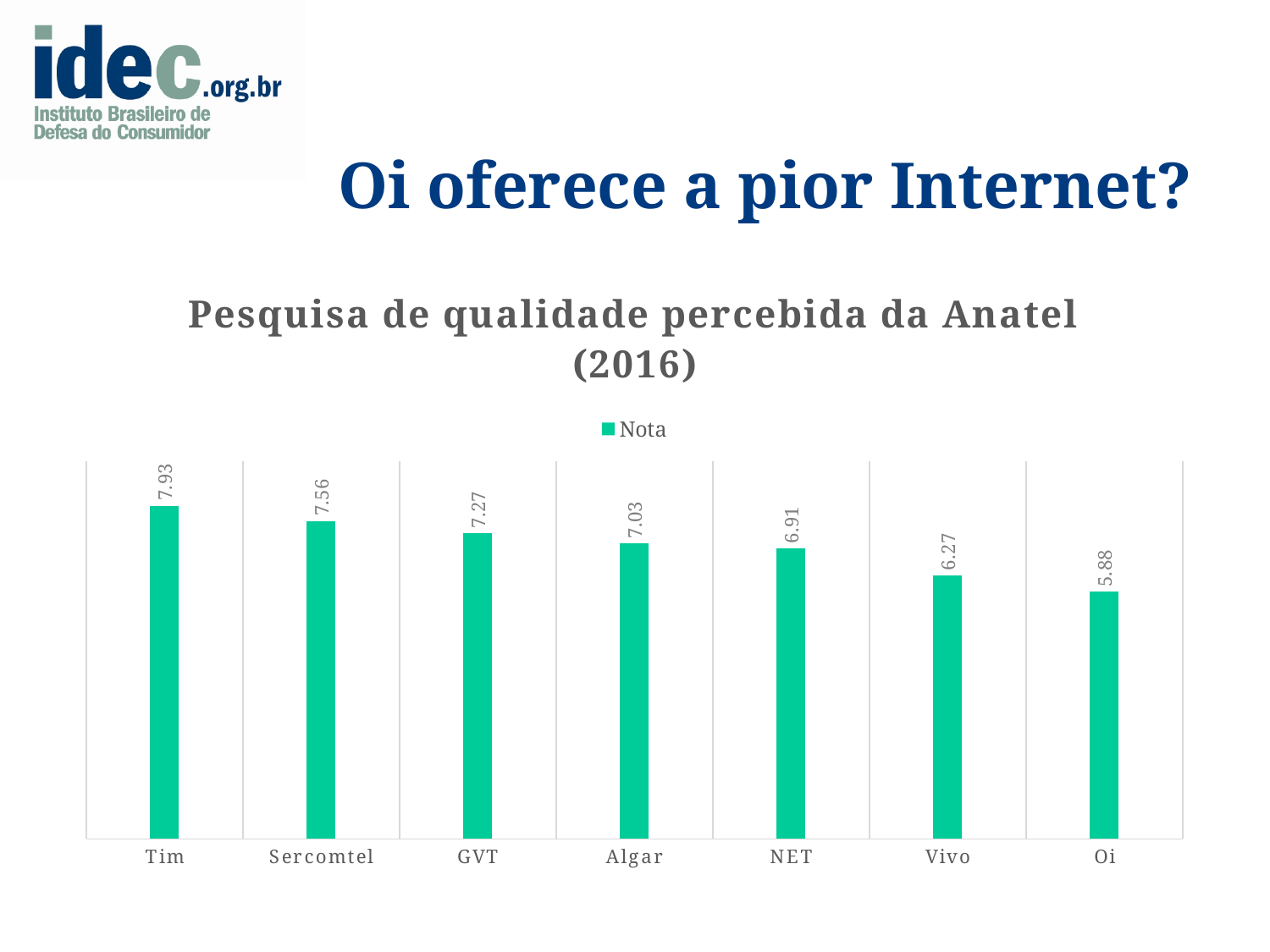
What kind of chart is shown on the slide? Bar chart What is the Nota value for Oi? 5.88 Which category has the highest Nota value? Tim What is the difference between the Nota values for Sercomtel and GVT? 0.29 What is the Nota value for Tim? 7.93 What is the Nota value for Vivo? 6.27 What is the difference between the Nota values for Tim and Oi? 2.05 How many categories are shown in the chart? 7 What is the title of the chart? Pesquisa de qualidade percebida da Anatel (2016) Which category has the lowest Nota value? Oi What is the Nota value for NET? 6.91 Which has a higher Nota value, Algar or Vivo? Algar